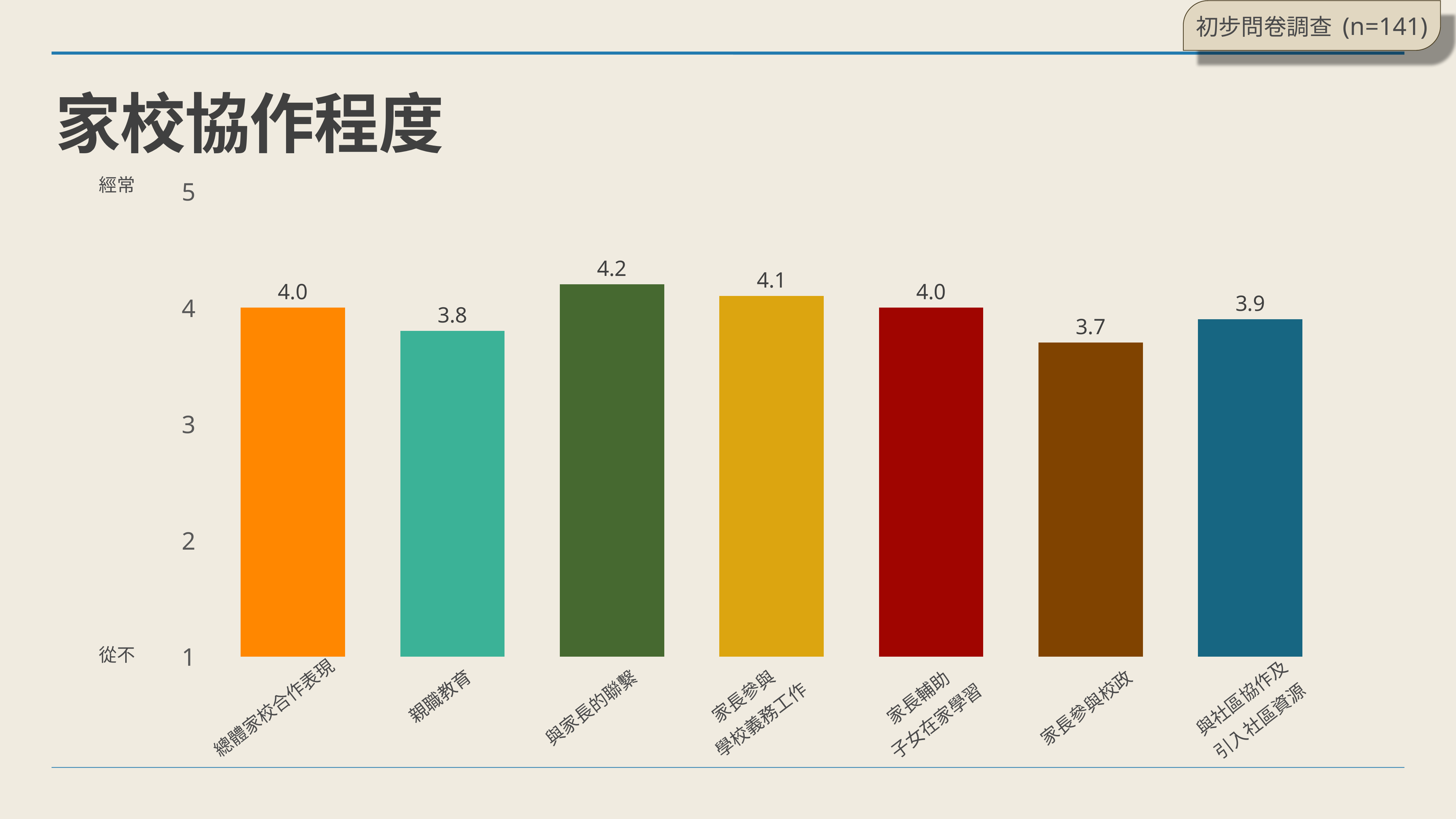
What is the value for 總體家校合作表現? 4.0 Which is larger, the value for 家長參與學校義務工作 or the value for 親職教育? 家長參與學校義務工作 What is the value for 家長參與校政? 3.7 How many categories are shown in the chart? 7 What is the title of the chart? 家校協作程度 What is the value for 親職教育? 3.8 Which category has the highest value? 與家長的聯繫 What is the value for 與社區協作及引入社區資源? 3.9 What is the difference between the values for 與家長的聯繫 and 家長參與校政? 0.5 What kind of chart is shown on the slide? Bar chart Which category has the lowest value? 家長參與校政 What is the value for 與家長的聯繫? 4.2